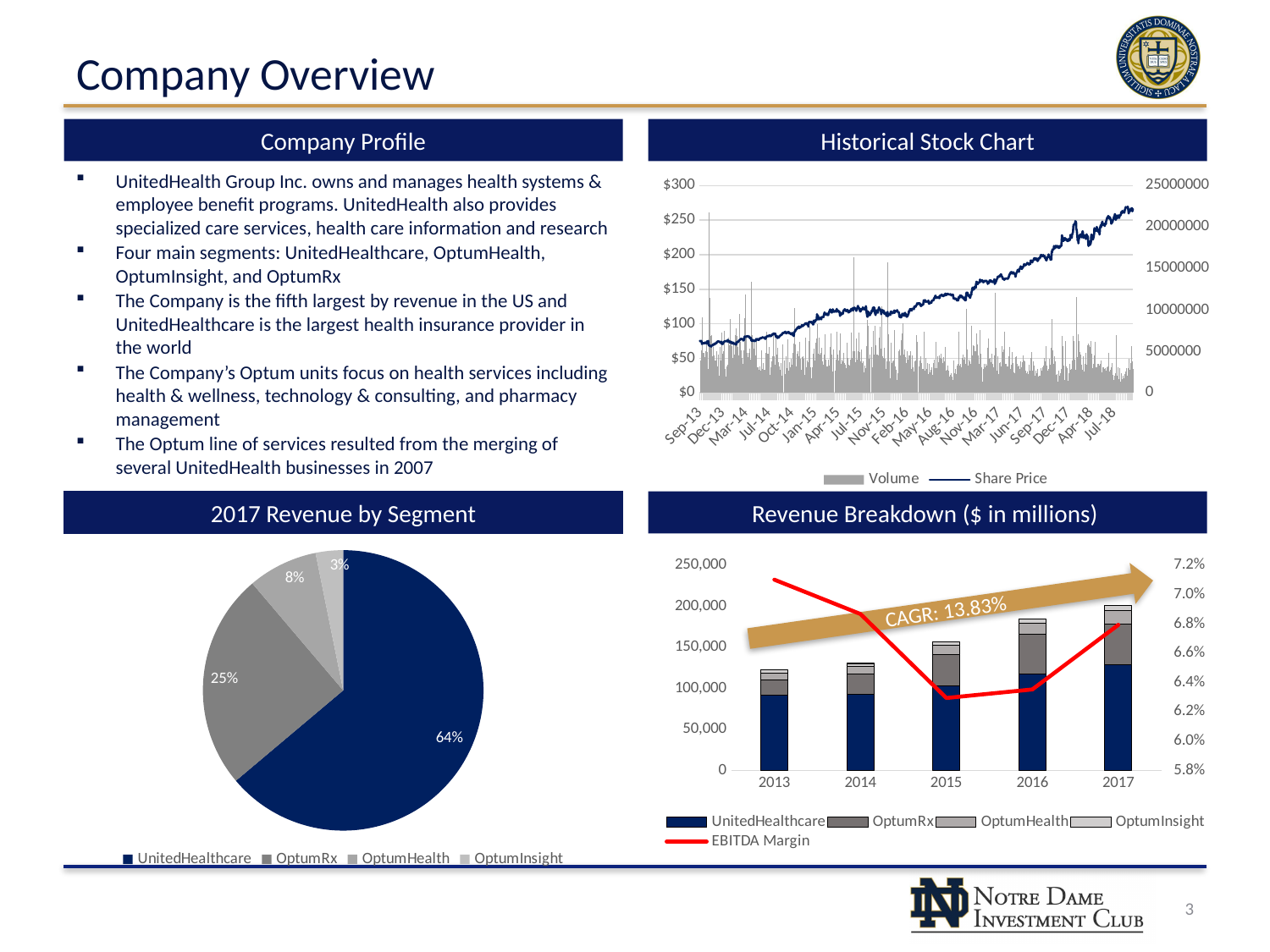
In the Revenue Breakdown chart, is the total revenue bar for 2017 greater or less than 150,000? greater In the Historical Stock Chart, how many series does the legend list? 2 In the Revenue Breakdown chart, what CAGR is annotated on the chart? 13.83% In the 2017 Revenue by Segment chart, what percentage is shown for OptumRx? 25% In the 2017 Revenue by Segment chart, what is the difference in percentage points between the UnitedHealthcare and OptumRx slices? 39 percentage points In the Historical Stock Chart, does the share price generally rise or fall from Sep-13 to Jul-18? Rise In the Revenue Breakdown chart, in which year is the EBITDA Margin line at its lowest? 2015 What kind of chart is the 2017 Revenue by Segment chart? Pie chart In the Revenue Breakdown chart, how many series does the legend list? 5 In the 2017 Revenue by Segment chart, what share of revenue does UnitedHealthcare account for? 64% In the 2017 Revenue by Segment chart, how many segments are shown in the pie? 4 In the 2017 Revenue by Segment chart, which segment has the smallest slice? OptumInsight